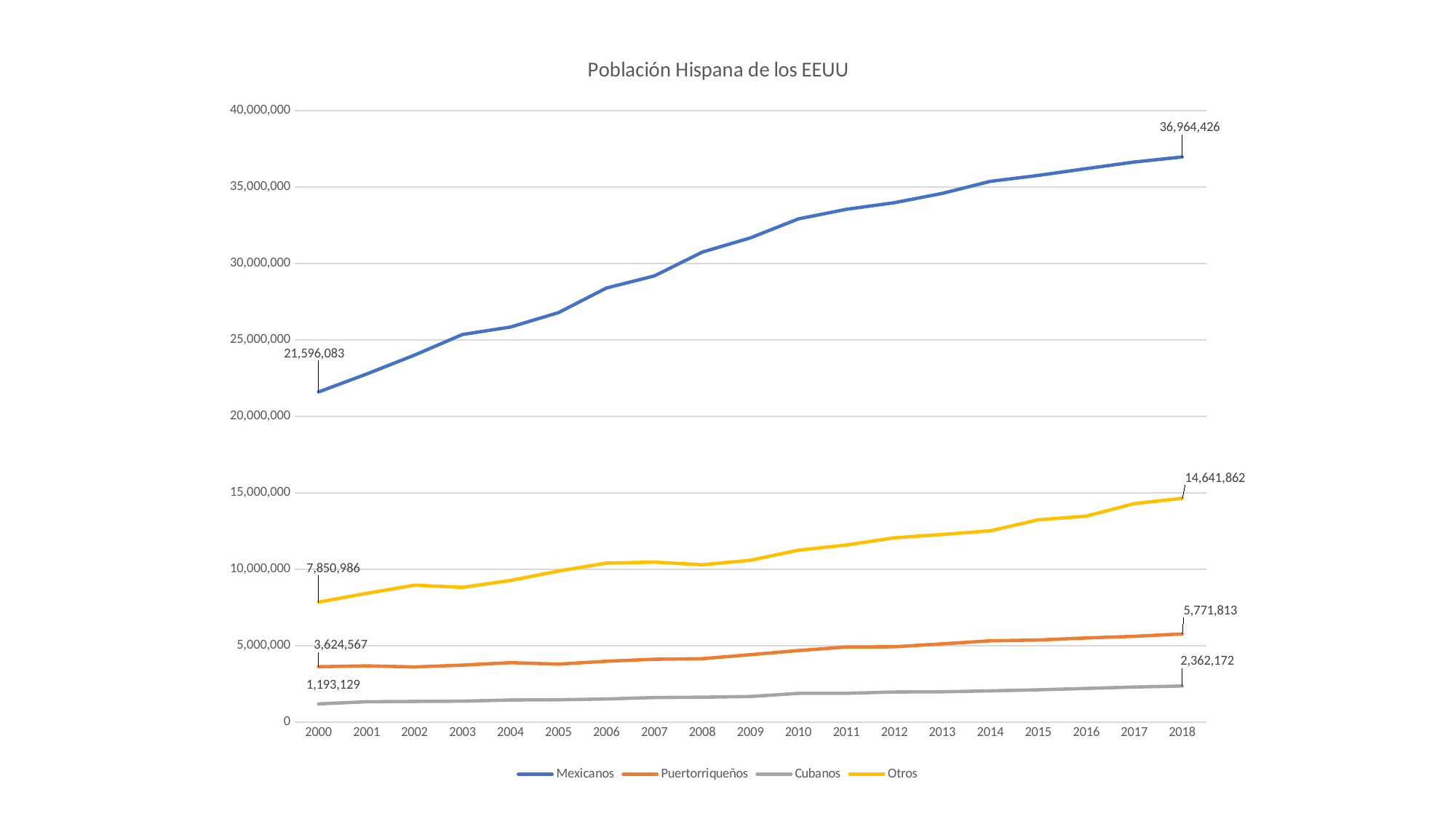
What type of chart is shown on the slide? Line chart Which series has the lowest value in 2000? Cubanos What is the difference between the Puertorriqueños values in 2018 and 2000? 2,147,246 Does the Otros series rise or fall from 2000 to 2018? Rise What is the value for Mexicanos in 2018? 36,964,426 Which series has the highest value in 2018? Mexicanos What is the value for Cubanos in 2018? 2,362,172 How many years are shown on the x axis? 19 Is the value for Mexicanos in 2010 greater or less than 30,000,000? greater How many series does the legend list? 4 What is the value for Otros in 2000? 7,850,986 What is the title of the chart? Población Hispana de los EEUU